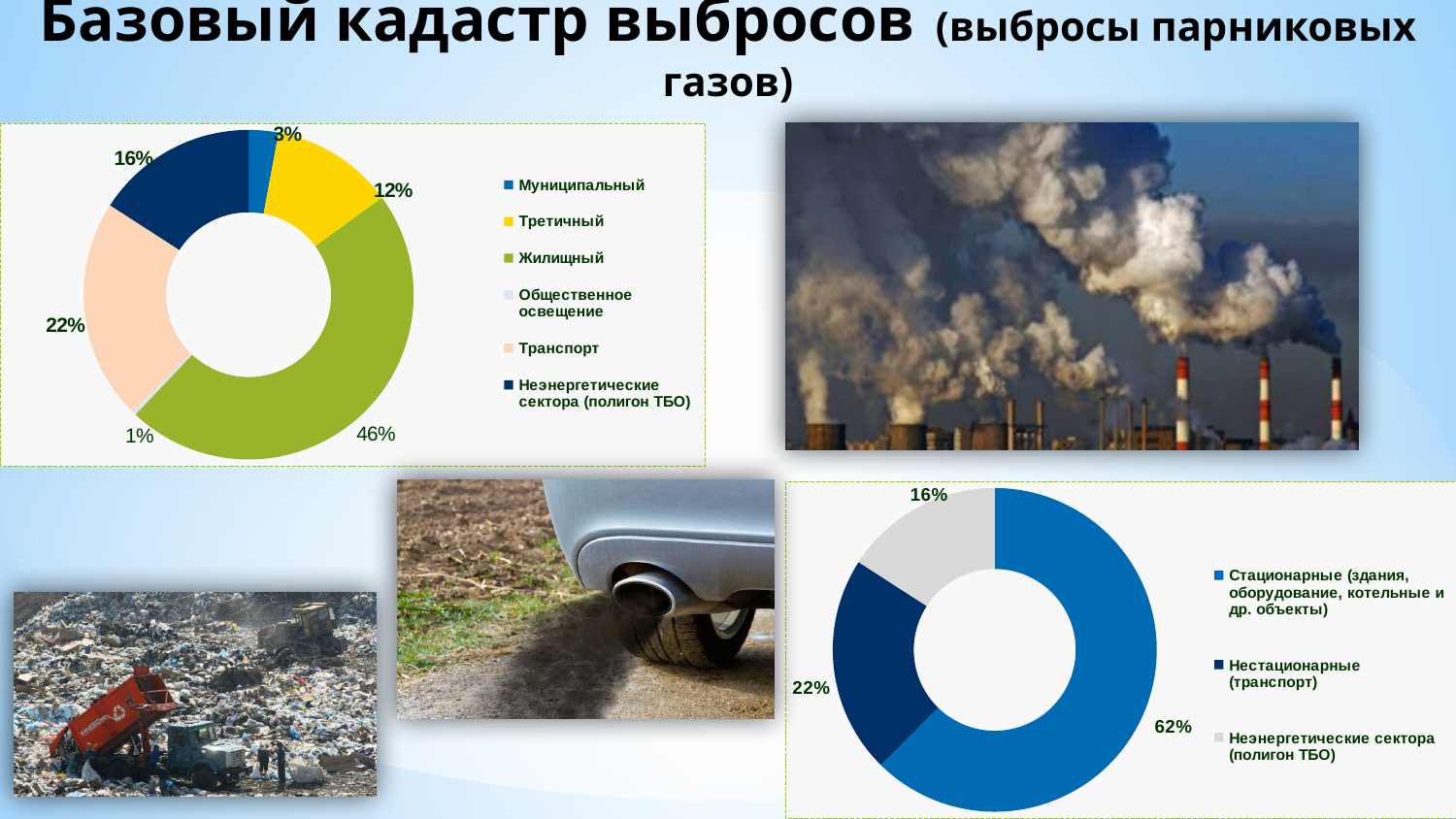
On the bottom-right chart, what is the difference between the shares of Стационарные and Нестационарные (транспорт)? 40% On the top-left chart, how many categories does the legend list? 6 What type of chart is the top-left chart? Doughnut (pie) chart On the top-left chart, which category has the smallest share? Общественное освещение On the bottom-right chart, which category has the smallest share? Неэнергетические сектора (полигон ТБО) On the top-left chart, which category has the largest share? Жилищный On the bottom-right chart, how many categories does the legend list? 3 On the top-left chart, what is the difference between the shares of Транспорт and Третичный? 10% On the bottom-right chart, what share is shown for Нестационарные (транспорт)? 22% On the top-left chart, what share is shown for Транспорт? 22% On the bottom-right chart, what share is shown for Стационарные (здания, оборудование, котельные и др. объекты)? 62% On the top-left chart, what share is shown for Жилищный? 46%